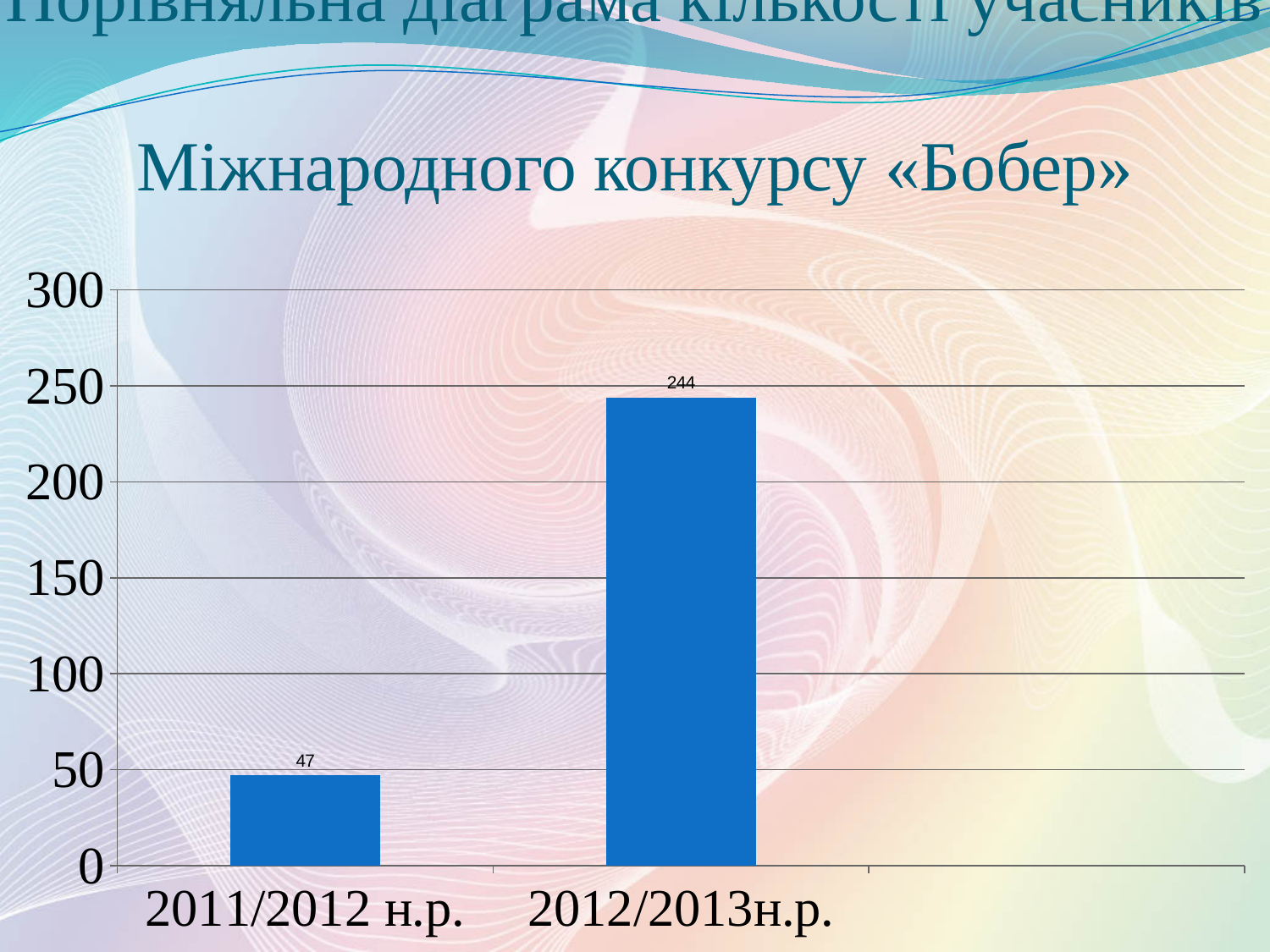
What is the highest value shown on the vertical axis? 300 Which category has the highest value? 2012/2013н.р. Which is larger, the value for 2011/2012 н.р. or the value for 2012/2013н.р.? 2012/2013н.р. What kind of chart is shown on the slide? bar chart What is the value for 2012/2013н.р.? 244 Do the values rise or fall from 2011/2012 н.р. to 2012/2013н.р.? rise Which category has the lowest value? 2011/2012 н.р. What is the difference between the values for 2012/2013н.р. and 2011/2012 н.р.? 197 What is the value for 2011/2012 н.р.? 47 Is the value for 2012/2013н.р. greater or less than 200? greater Is the value for 2011/2012 н.р. greater or less than 50? less How many categories are shown on the x axis? 2